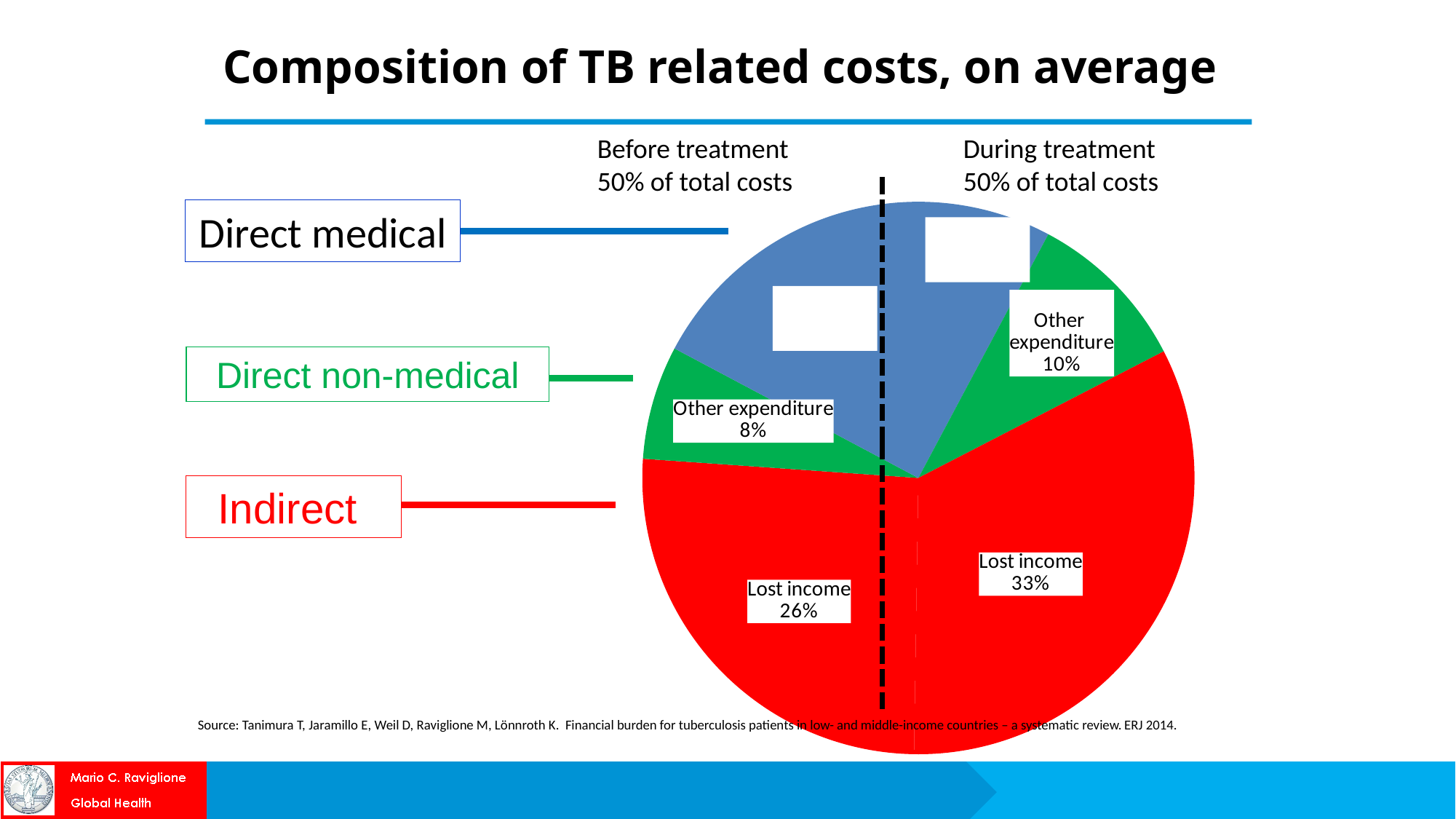
What percentage of total costs is lost income before treatment? 26% What is the title of the slide? Composition of TB related costs, on average What percentage of total costs is other expenditure during treatment? 10% Which labelled slice of the pie is the largest? Lost income 33% (during treatment) Which is larger: lost income before treatment or lost income during treatment? Lost income during treatment What is the difference in percentage points between other expenditure during treatment and other expenditure before treatment? 2 What percentage of total costs is other expenditure before treatment? 8% Which colour represents indirect costs in the pie chart? Red What percentage of total costs is lost income during treatment? 33% What share of total costs is incurred before treatment according to the slide? 50% of total costs What type of chart is shown on the slide? Pie chart What is the difference in percentage points between lost income during treatment and lost income before treatment? 7